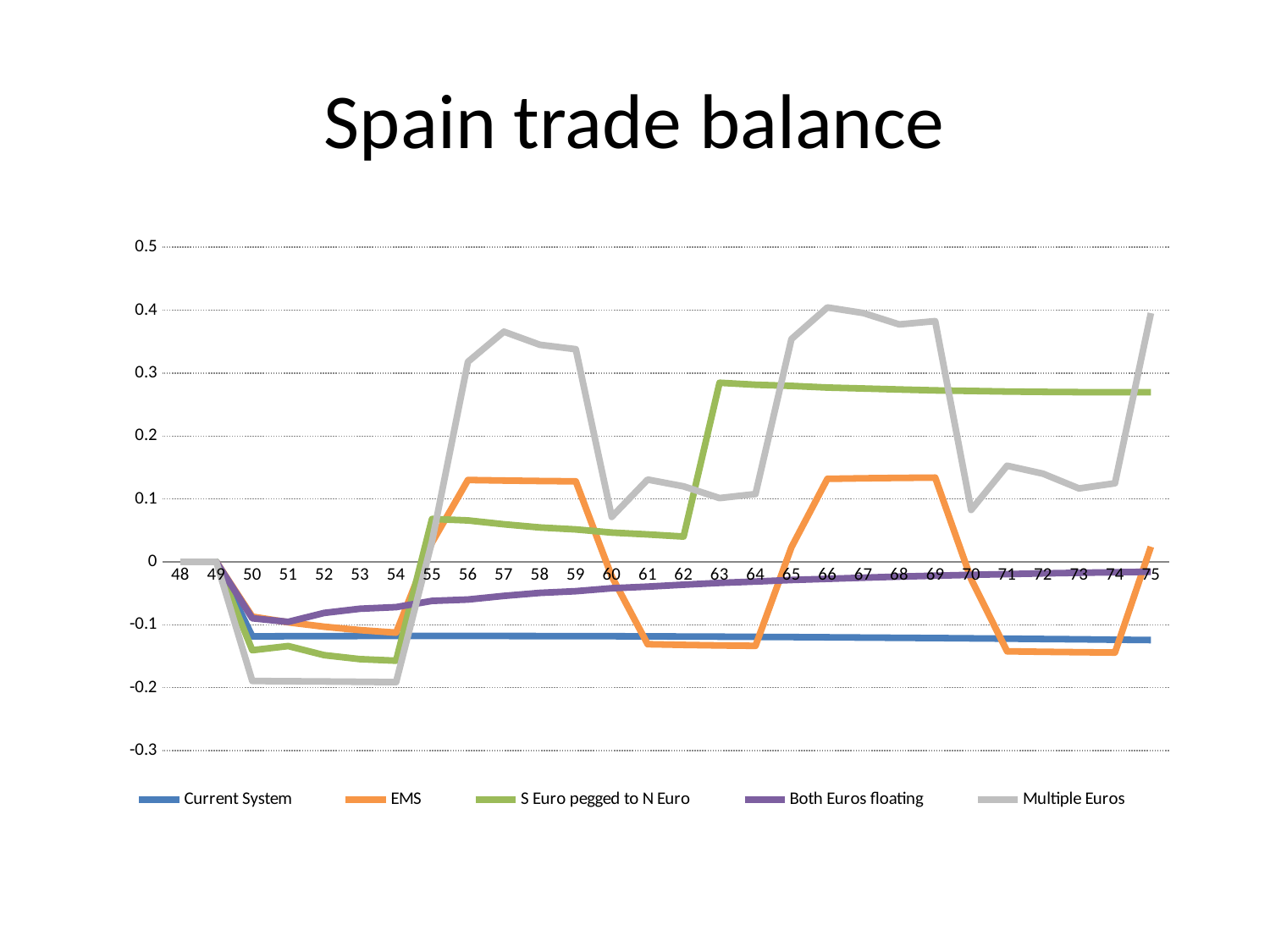
How many points are labelled along the x axis? 28 What is the title of the chart? Spain trade balance What kind of chart is shown on the slide? line chart How many series does the legend list? 5 At x = 66, which is larger: Multiple Euros or EMS? Multiple Euros Is the value for S Euro pegged to N Euro at x = 63 greater or less than 0.2? greater Is the value for Multiple Euros at x = 57 greater or less than 0.3? greater Which series is shown in grey in the legend? Multiple Euros Which series reaches the highest value anywhere on the chart? Multiple Euros At x = 60, which is larger: EMS or S Euro pegged to N Euro? S Euro pegged to N Euro Is the value for Multiple Euros at x = 50 greater or less than -0.1? less Which series has the lowest value at x = 52? Multiple Euros